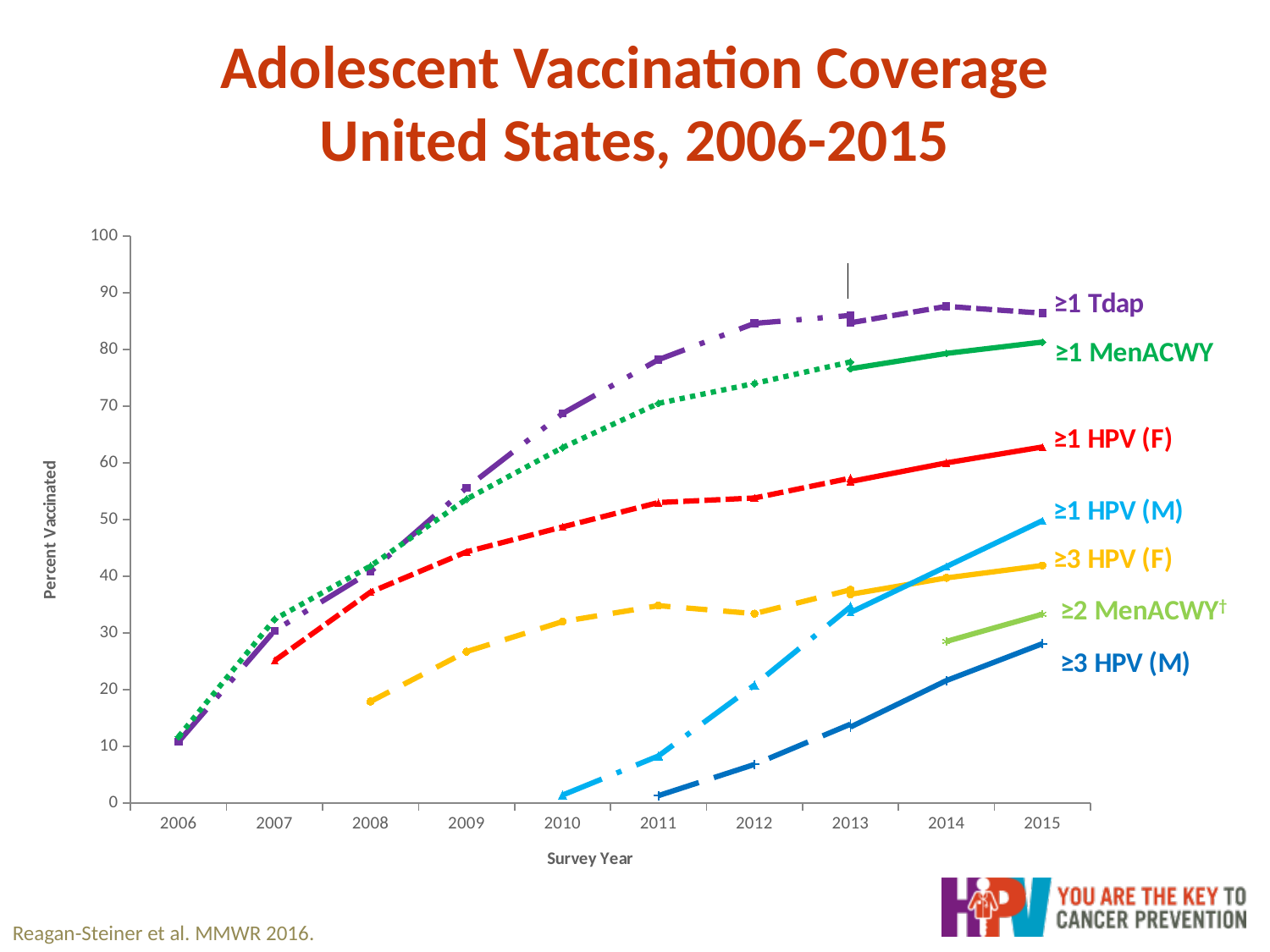
Is the value for ≥1 HPV (M) in 2010 greater or less than 10? less Is the value for ≥3 HPV (F) in 2008 greater or less than 20? less How many vaccination series are labelled on the chart? 7 In 2015, which is larger: ≥1 HPV (F) or ≥3 HPV (F)? ≥1 HPV (F) Which series has the lowest coverage in 2015? ≥3 HPV (M) Is the value for ≥1 Tdap in 2015 greater or less than 80? greater How many survey years are shown on the x axis? 10 In which survey year does the ≥2 MenACWY† series first appear? 2014 Which series has the highest coverage in 2015? ≥1 Tdap Does the ≥1 HPV (F) series rise or fall from 2007 to 2015? rise What kind of chart is shown on the slide? line chart What is the label of the y axis? Percent Vaccinated